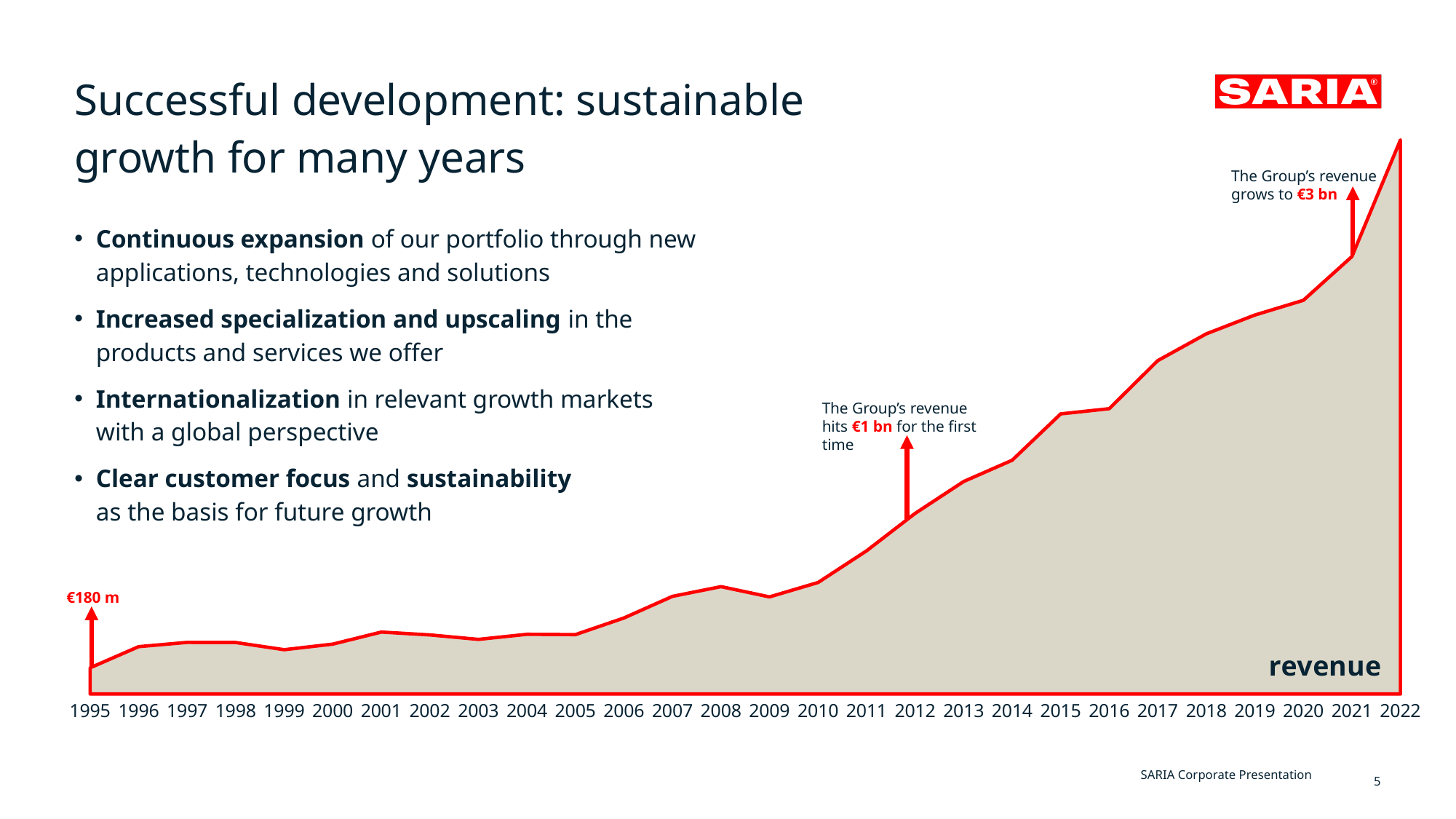
Which year has higher revenue, 2010 or 2022? 2022 Which year has higher revenue, 2008 or 2009? 2008 What is the name of the series plotted in the chart? revenue What is the first year shown on the x axis of the chart? 1995 How many years are shown on the x axis of the chart? 28 What kind of chart is shown on the slide? area chart Does revenue generally rise or fall from 1995 to 2022? rise To what value does the annotation say the Group's revenue grows in 2021? €3 bn Which year has the highest revenue in the chart? 2022 What is the revenue value labelled for 1995? €180 m In which year does the annotation say the Group's revenue hits €1 bn for the first time? 2012 Which year has the lowest revenue in the chart? 1995